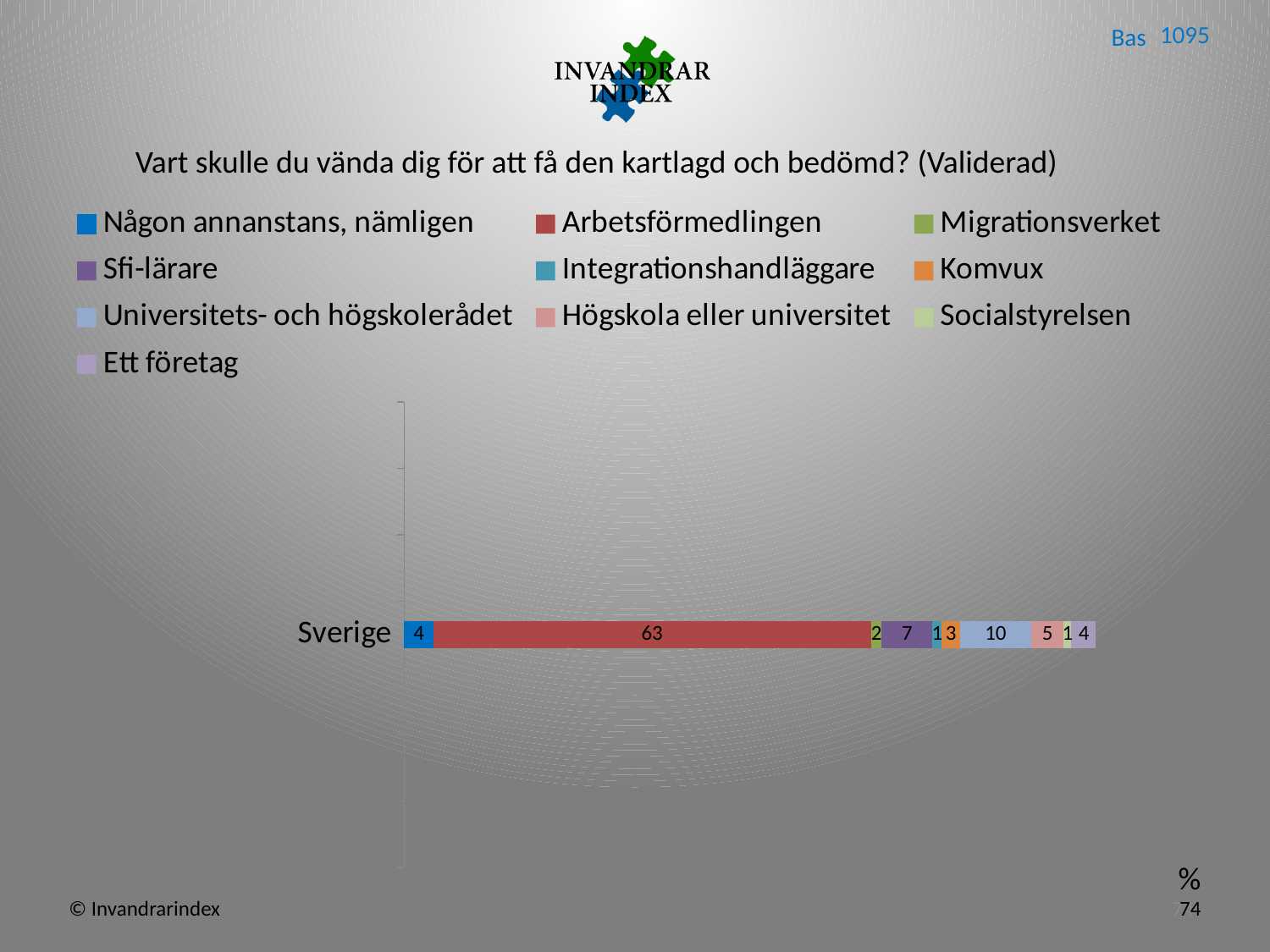
What is the value for Universitets- och högskolerådet for Sverige? 10 What is the title of the chart? Vart skulle du vända dig för att få den kartlagd och bedömd? (Validerad) How many series does the legend list? 10 What kind of chart is shown on the slide? Stacked bar chart What is the difference between the values for Arbetsförmedlingen and Universitets- och högskolerådet for Sverige? 53 What is the value for Sfi-lärare for Sverige? 7 What is the value for Arbetsförmedlingen for Sverige? 63 Which is larger for Sverige, Sfi-lärare or Komvux? Sfi-lärare How many categories are plotted on the chart? 1 What is the total of the stacked bar for Sverige? 100 Which series has the highest value for Sverige? Arbetsförmedlingen What is the value for Högskola eller universitet for Sverige? 5